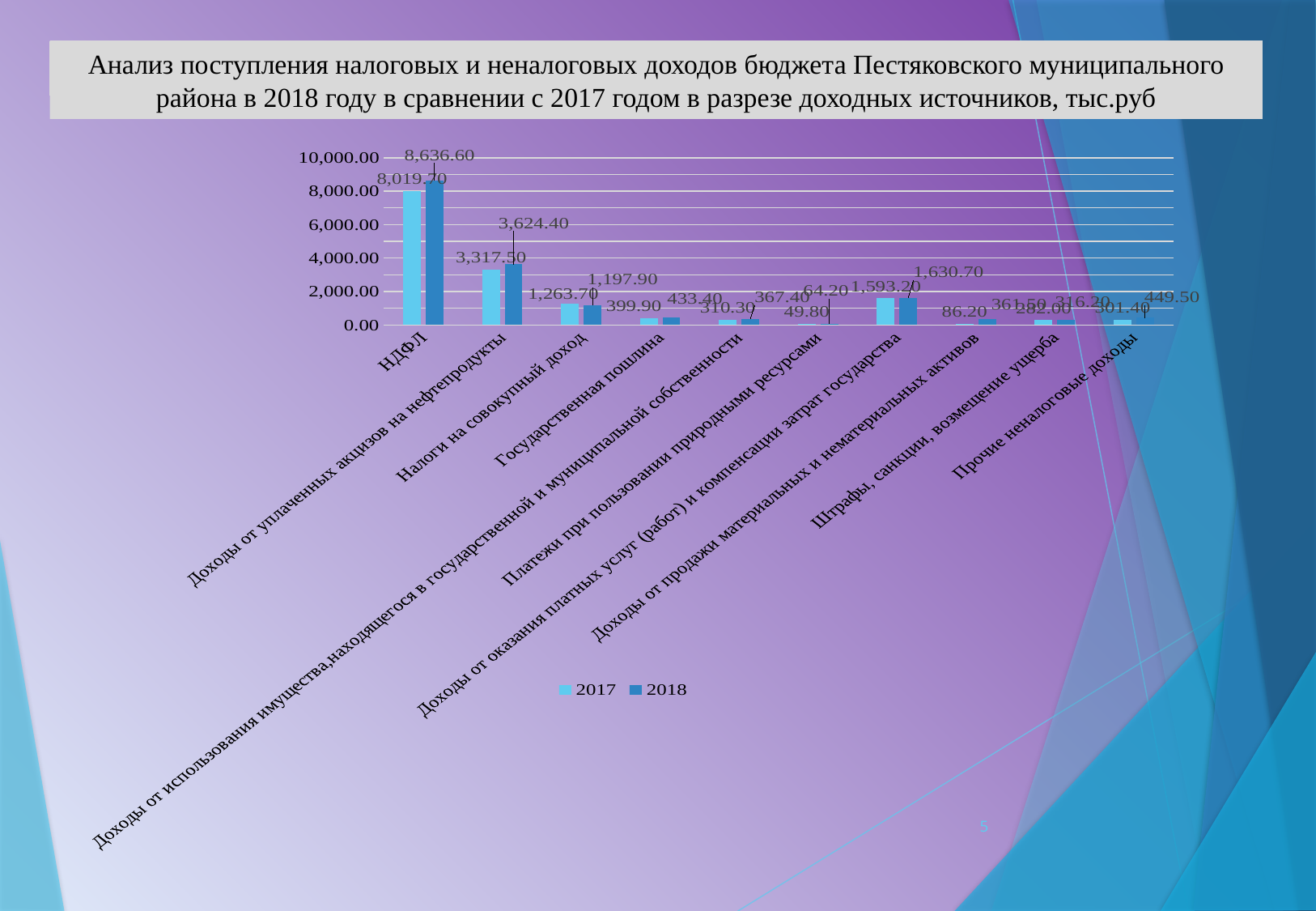
What is the 2018 value for НДФЛ? 8,636.60 For Налоги на совокупный доход, which year has the larger value, 2017 or 2018? 2017 What kind of chart is shown on the slide? bar chart What is the difference between the 2018 and 2017 values for НДФЛ? 616.90 How many series does the legend list? 2 How many income source categories are shown on the x axis? 10 Is the 2018 value for Доходы от оказания платных услуг (работ) и компенсации затрат государства greater or less than 2,000.00? less What is the 2018 value for Государственная пошлина? 433.40 Which category has the lowest 2017 value? Платежи при пользовании природными ресурсами Which category has the highest 2018 value? НДФЛ Which two years are listed in the legend? 2017 and 2018 What is the 2017 value for Доходы от уплаченных акцизов на нефтепродукты? 3,317.50